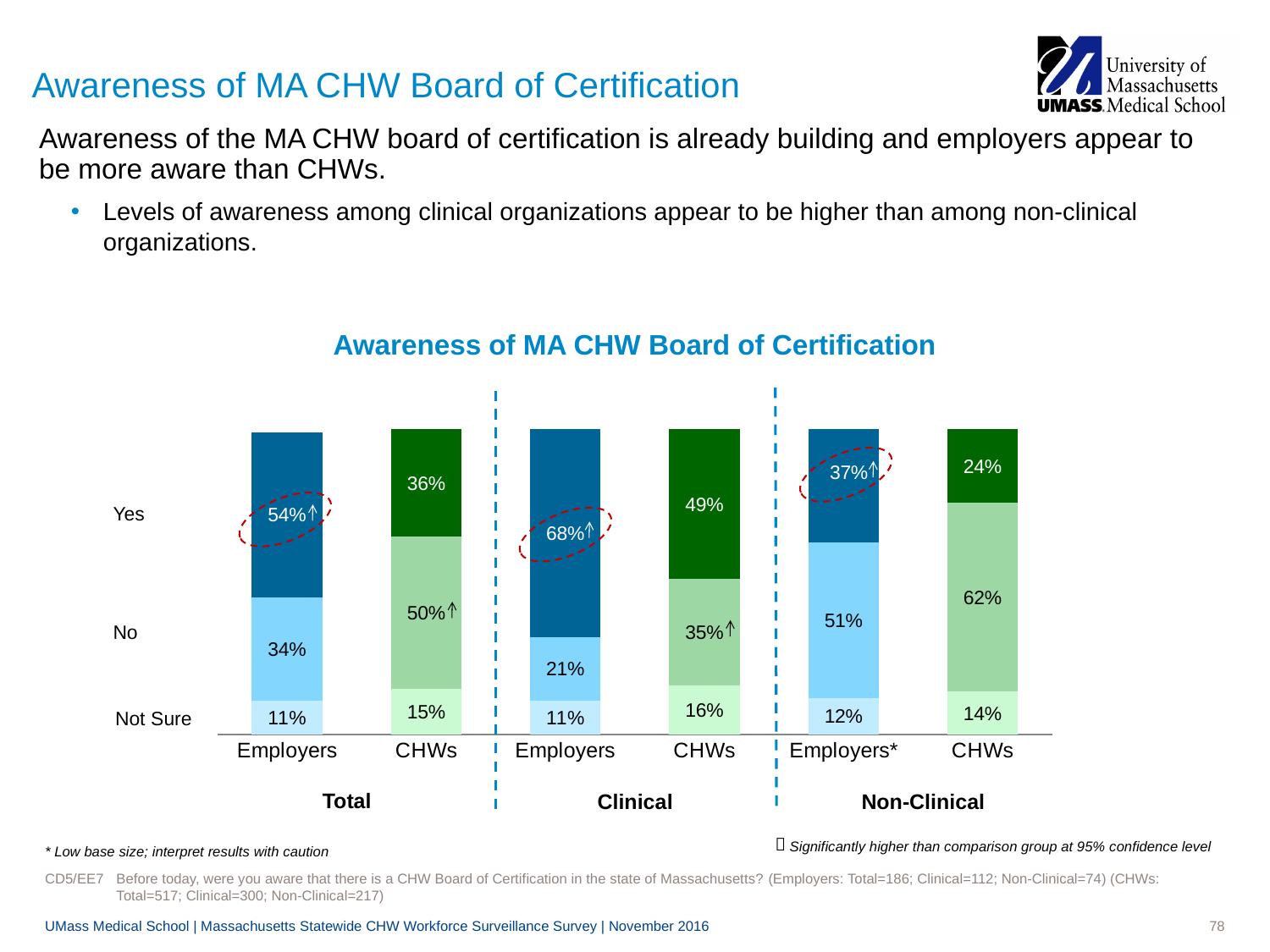
What type of chart is shown on the slide? Stacked bar chart Which is larger: the No percentage for Total CHWs or for Total Employers? Total CHWs What percentage of Non-Clinical CHWs answered Not Sure? 14% How many bars are shown in the chart? 6 What is the title of the chart? Awareness of MA CHW Board of Certification How many response categories (series) are stacked in each bar? 3 What is the difference between the Yes percentage for Clinical Employers and Clinical CHWs? 19% What percentage of Clinical CHWs answered No? 35% Which bar has the lowest Yes percentage? Non-Clinical CHWs Which bar has the highest Yes percentage? Clinical Employers What percentage of Total Employers answered Yes to awareness of the MA CHW Board of Certification? 54% What percentage of Non-Clinical Employers* answered Yes? 37%